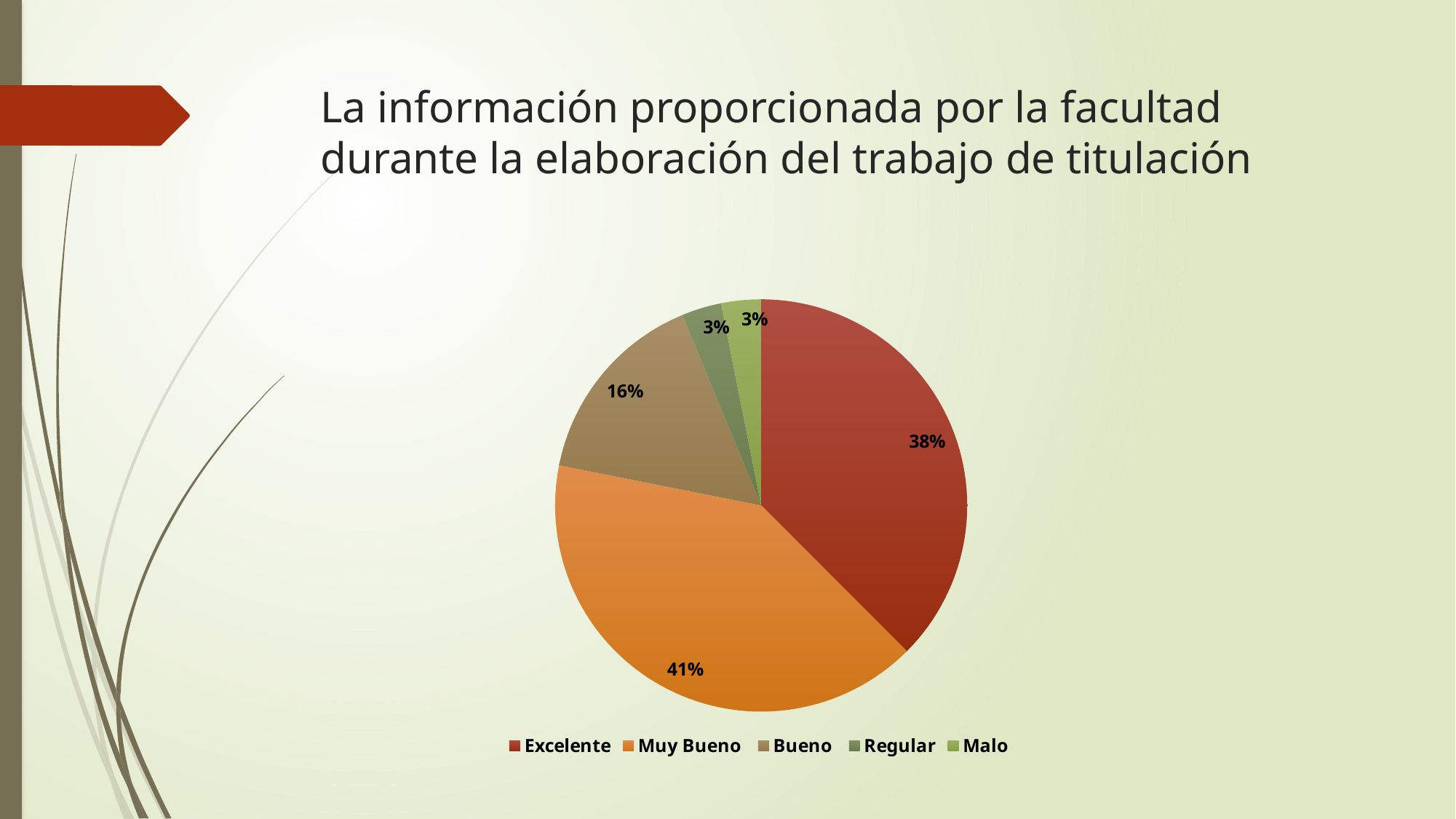
Which category has the largest share of the pie chart? Muy Bueno What percentage of the pie chart is labelled Bueno? 16% What is the difference in percentage points between the Excelente and Bueno slices? 22 What is the combined share of the Excelente and Muy Bueno slices? 79% What kind of chart is shown on the slide? Pie chart What percentage of the pie chart is labelled Excelente? 38% What is the difference in percentage points between the Muy Bueno and Excelente slices? 3 What percentage of the pie chart is labelled Muy Bueno? 41% Which legend entry is shown in orange? Muy Bueno Which slice is larger, Bueno or Regular? Bueno How many categories does the legend of the pie chart list? 5 What percentage of the pie chart is labelled Regular? 3%